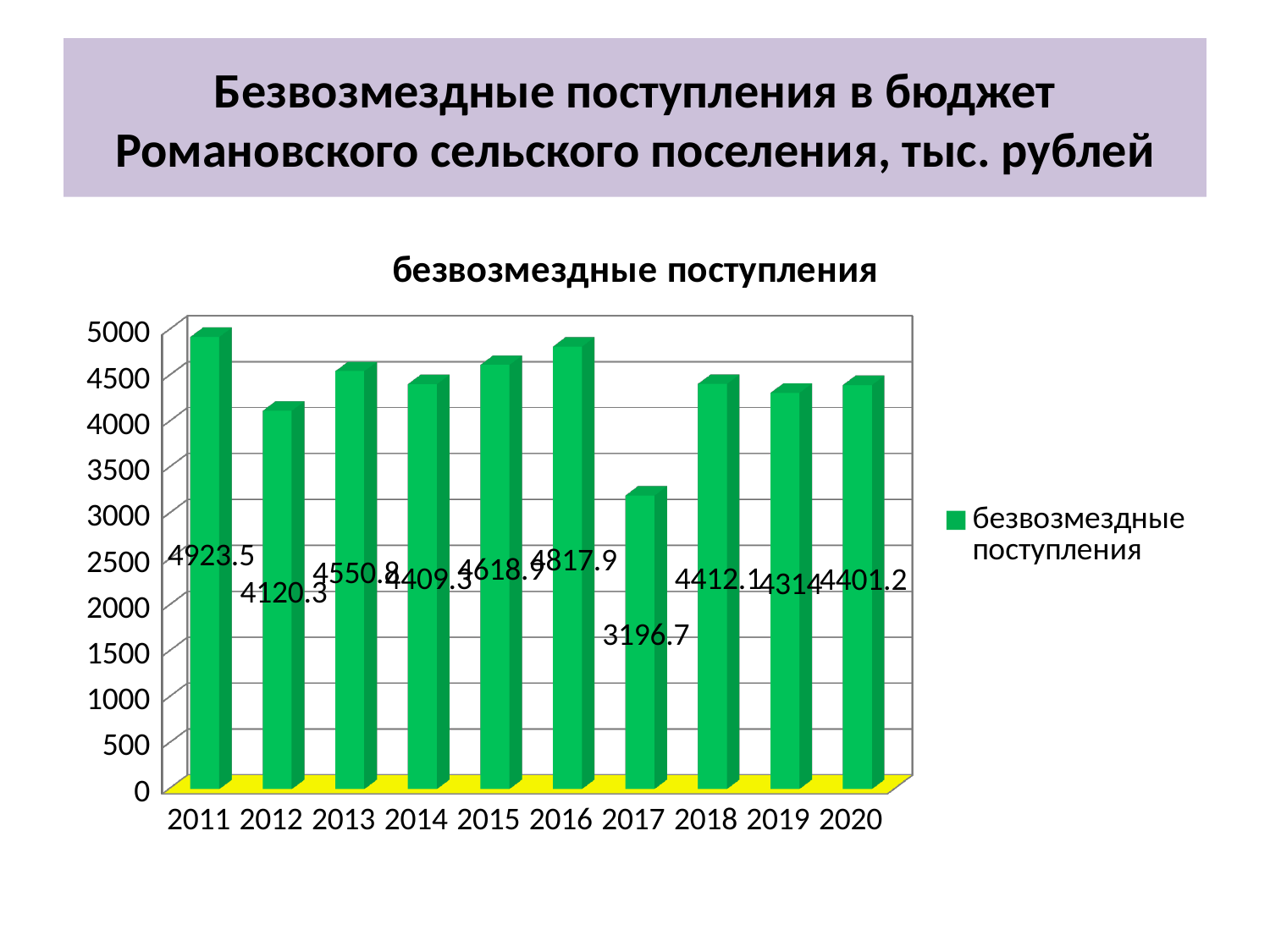
Which year has the lowest value? 2017 Is the value for 2017 greater or less than 3500? less How many years are shown on the x axis? 10 What kind of chart is shown? bar chart How many series does the legend list? 1 What is the value for 2011? 4923.5 What is the value for 2017? 3196.7 Which is larger, the value for 2012 or the value for 2016? 2016 What is the difference between the values for 2011 and 2017? 1726.8 Which year has the highest value? 2011 What is the value for 2016? 4817.9 What is the value for 2012? 4120.3